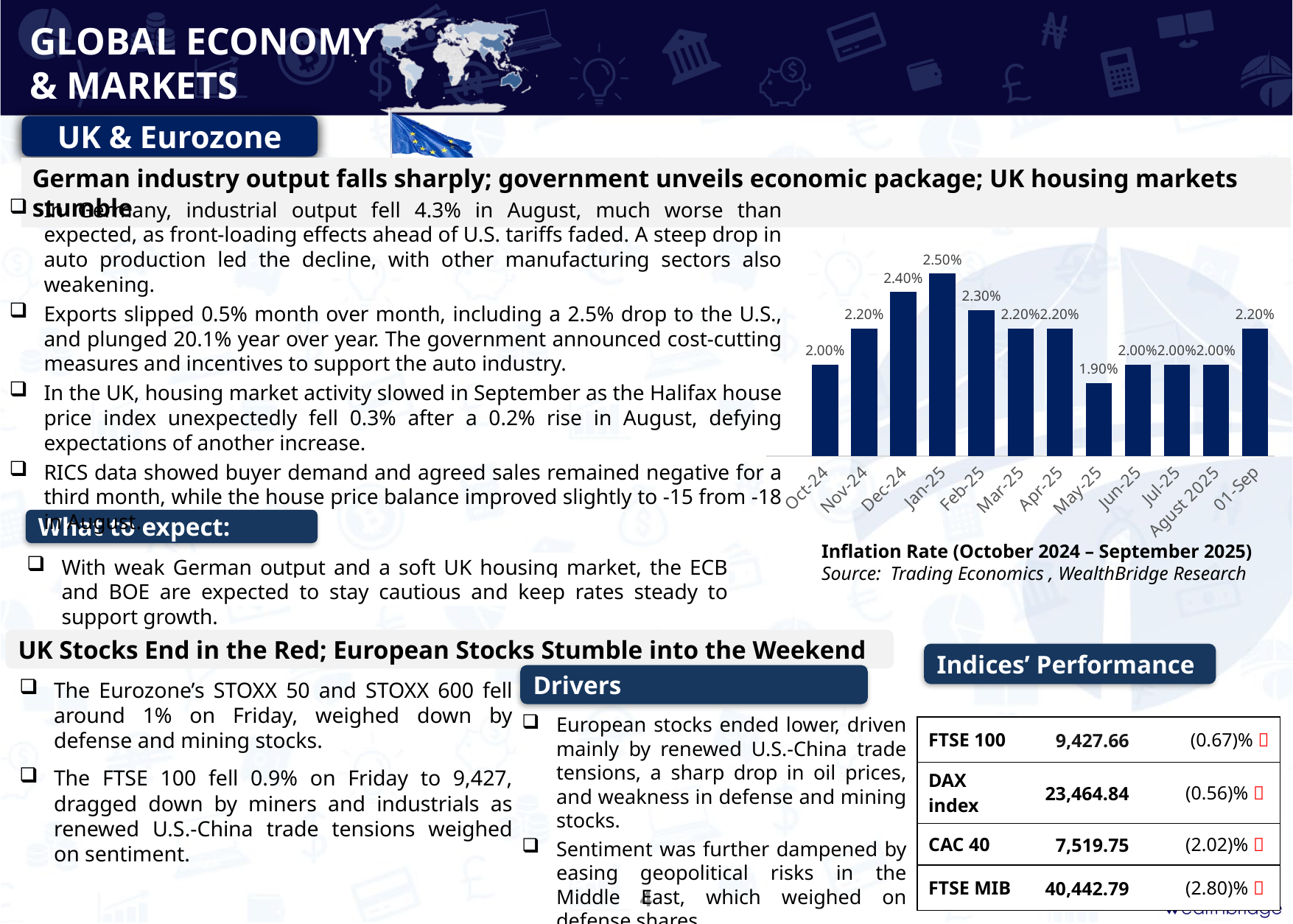
Which month has the lowest inflation rate in the chart? May-25 What type of chart is shown on the slide? bar chart Does the inflation rate rise or fall from Jan-25 to May-25? fall What is the title of the chart? Inflation Rate (October 2024 – September 2025) What is the inflation rate shown for Jan-25? 2.50% What is the difference between the inflation rate in Jan-25 and May-25? 0.60% Which month has the highest inflation rate in the chart? Jan-25 Which is higher, the inflation rate for Dec-24 or for Feb-25? Dec-24 What is the inflation rate shown for Dec-24? 2.40% What is the difference between the inflation rate in Oct-24 and Nov-24? 0.20% How many months are plotted in the chart? 12 What is the inflation rate shown for May-25? 1.90%